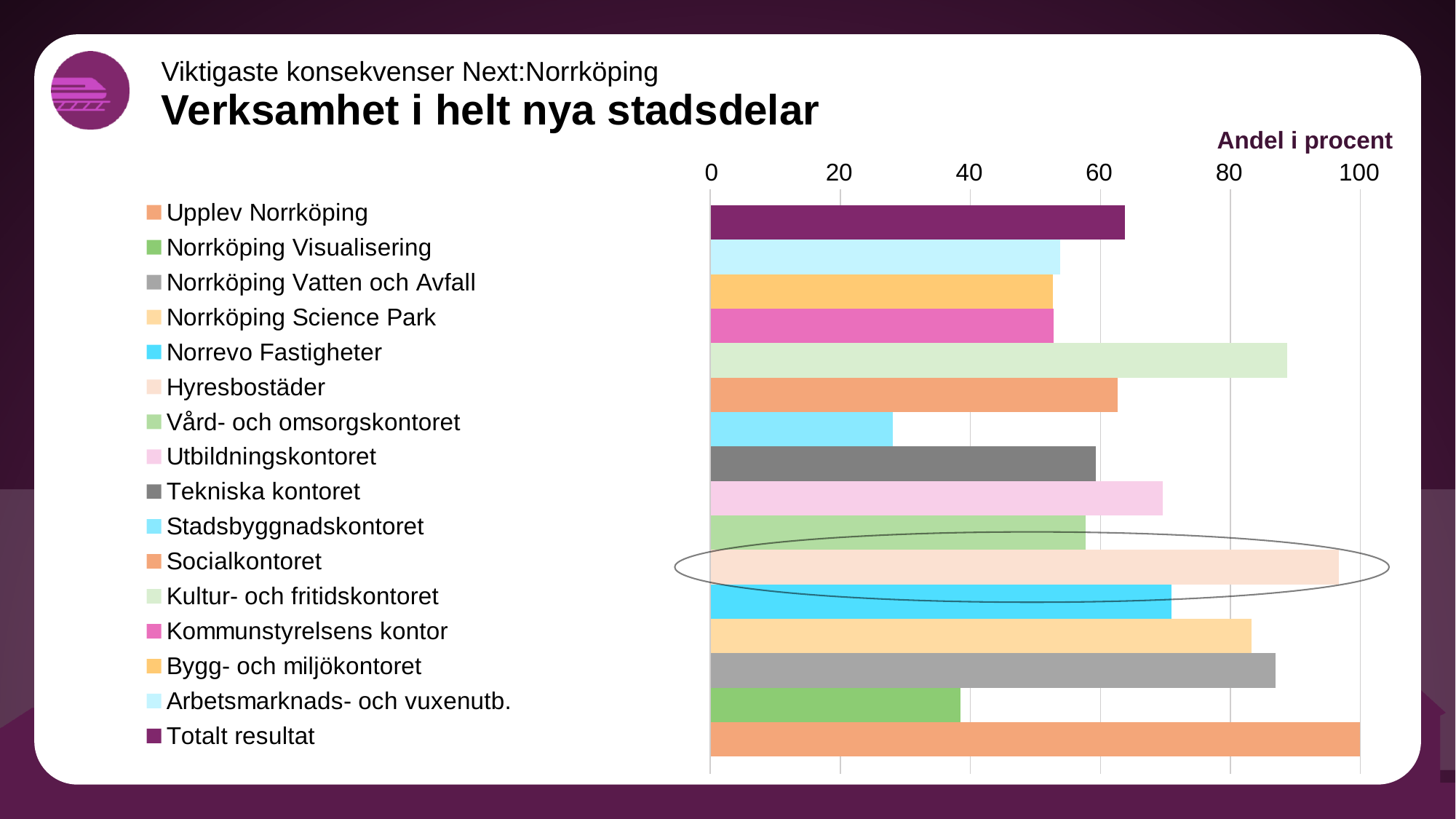
Is the value for Stadsbyggnadskontoret greater or less than 40? less How many series does the legend list? 16 Is the value for Hyresbostäder greater or less than 80? greater What kind of chart is shown on the slide? bar chart Which is larger, the value for Norrevo Fastigheter or the value for Norrköping Visualisering? Norrevo Fastigheter Is the value for Totalt resultat greater or less than 60? greater What label is shown above the horizontal axis of the chart? Andel i procent Which category has the lowest value? Stadsbyggnadskontoret Which is larger, the value for Hyresbostäder or the value for Totalt resultat? Hyresbostäder What is the value for Upplev Norrköping? 100 Which category has the highest value? Upplev Norrköping